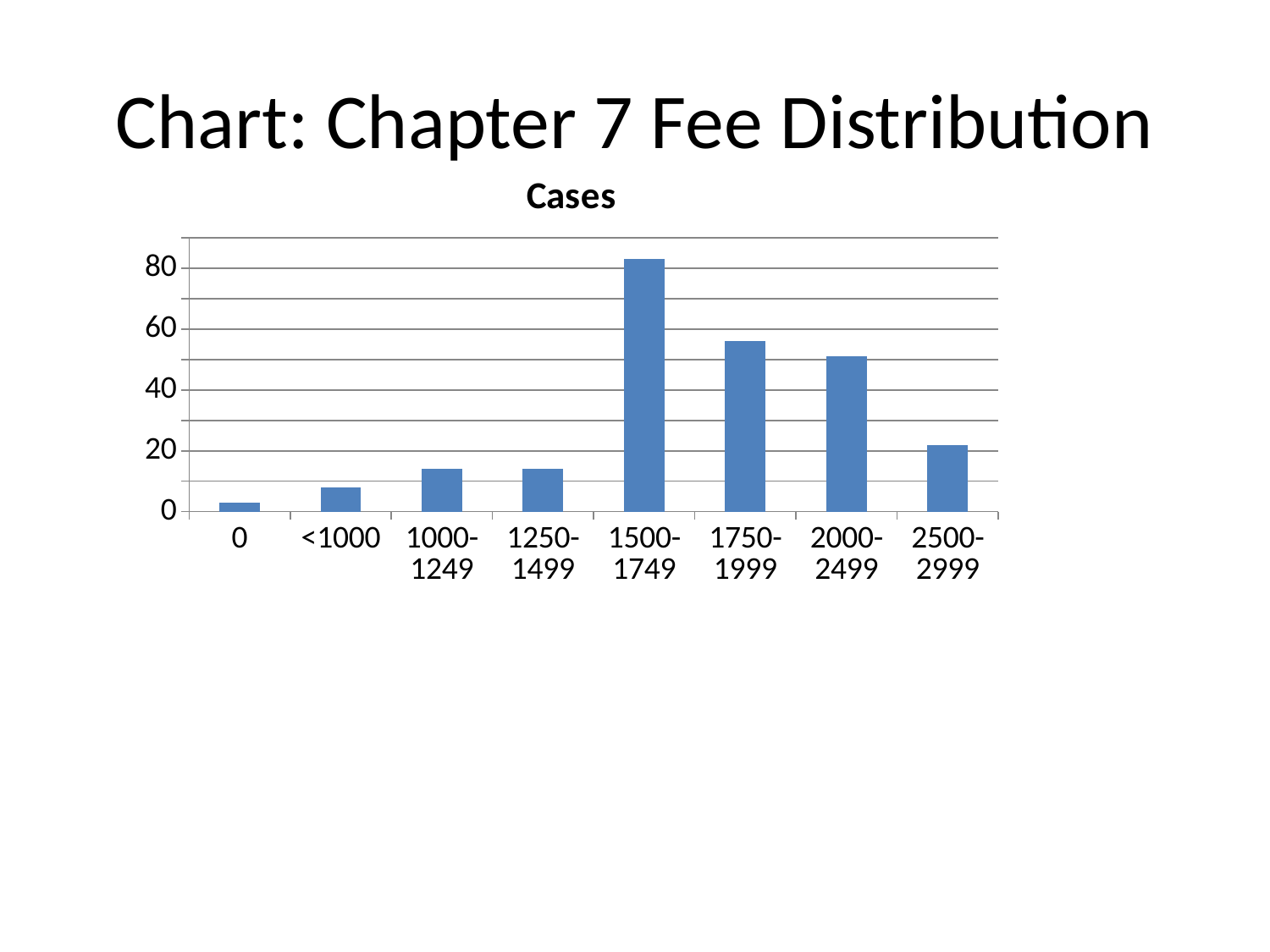
What kind of chart is shown on the slide? bar chart Is the value for 2500-2999 greater or less than 40? less Which has more cases, 2500-2999 or <1000? 2500-2999 Which category has the highest number of cases? 1500-1749 Is the value for 1500-1749 greater or less than 80? greater Is the value for <1000 greater or less than 20? less What is the title of the chart? Cases How many categories are shown on the x axis of the chart? 8 Which category has the lowest number of cases? 0 Which has more cases, 1500-1749 or 1750-1999? 1500-1749